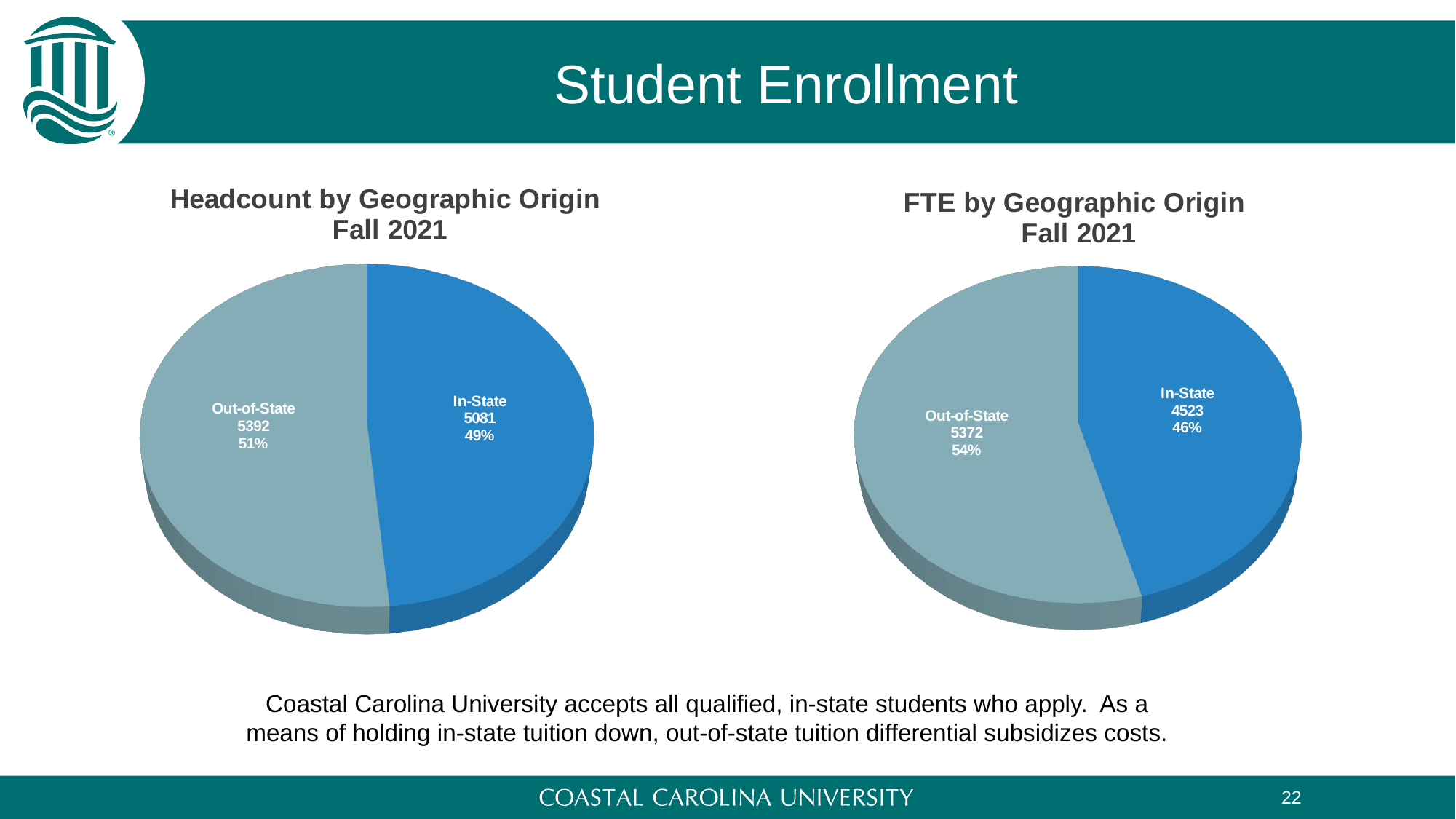
In the 'FTE by Geographic Origin Fall 2021' chart, what share of the pie is In-State? 46% How many categories does the 'Headcount by Geographic Origin Fall 2021' chart show? 2 In the 'Headcount by Geographic Origin Fall 2021' chart, what is the headcount for In-State students? 5081 In the 'Headcount by Geographic Origin Fall 2021' chart, which category is the smallest? In-State In the 'FTE by Geographic Origin Fall 2021' chart, which category is the largest? Out-of-State In the 'FTE by Geographic Origin Fall 2021' chart, what is the FTE value for In-State students? 4523 In the 'Headcount by Geographic Origin Fall 2021' chart, what is the difference between the Out-of-State and In-State headcounts? 311 In the 'Headcount by Geographic Origin Fall 2021' chart, what is the headcount for Out-of-State students? 5392 In the 'FTE by Geographic Origin Fall 2021' chart, what is the FTE value for Out-of-State students? 5372 What kind of chart is the 'FTE by Geographic Origin Fall 2021' chart? Pie chart In the 'Headcount by Geographic Origin Fall 2021' chart, what share of the pie is Out-of-State? 51% In the 'FTE by Geographic Origin Fall 2021' chart, what is the difference between the Out-of-State and In-State FTE values? 849